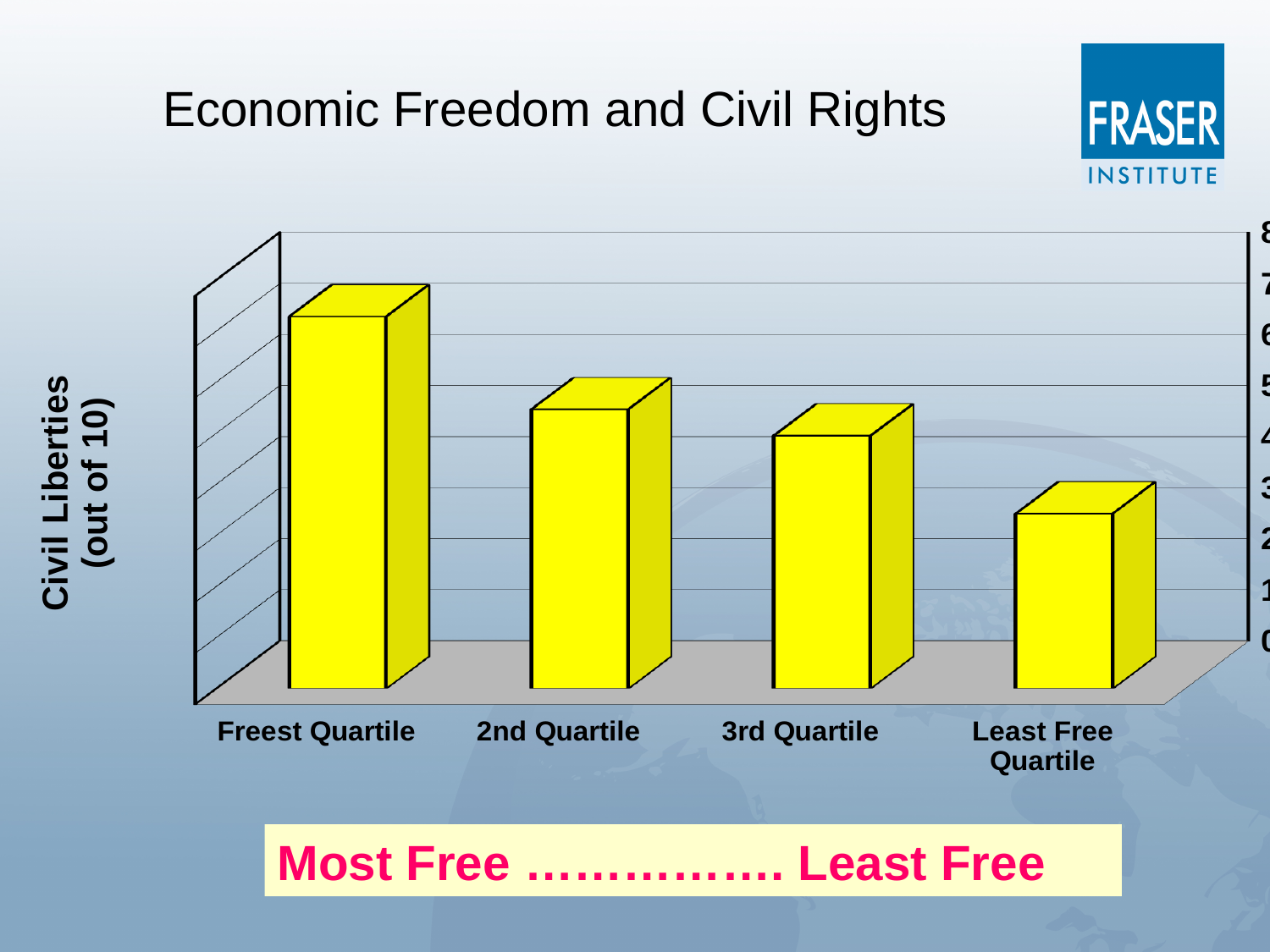
Is the value for the 3rd Quartile greater or less than 3? greater Is the value for the Least Free Quartile greater or less than 4? less Which quartile has the highest civil liberties score? Freest Quartile Which has a higher civil liberties score, the Freest Quartile or the Least Free Quartile? Freest Quartile What is the title of the slide containing the chart? Economic Freedom and Civil Rights What kind of chart is shown on the slide? bar chart Which has a higher civil liberties score, the 2nd Quartile or the Least Free Quartile? 2nd Quartile How many quartile categories are plotted in the chart? 4 What is the label of the vertical axis? Civil Liberties (out of 10) Which quartile has the lowest civil liberties score? Least Free Quartile Do the civil liberties values rise or fall moving from the Freest Quartile to the Least Free Quartile? fall Is the value for the Freest Quartile greater or less than 5? greater